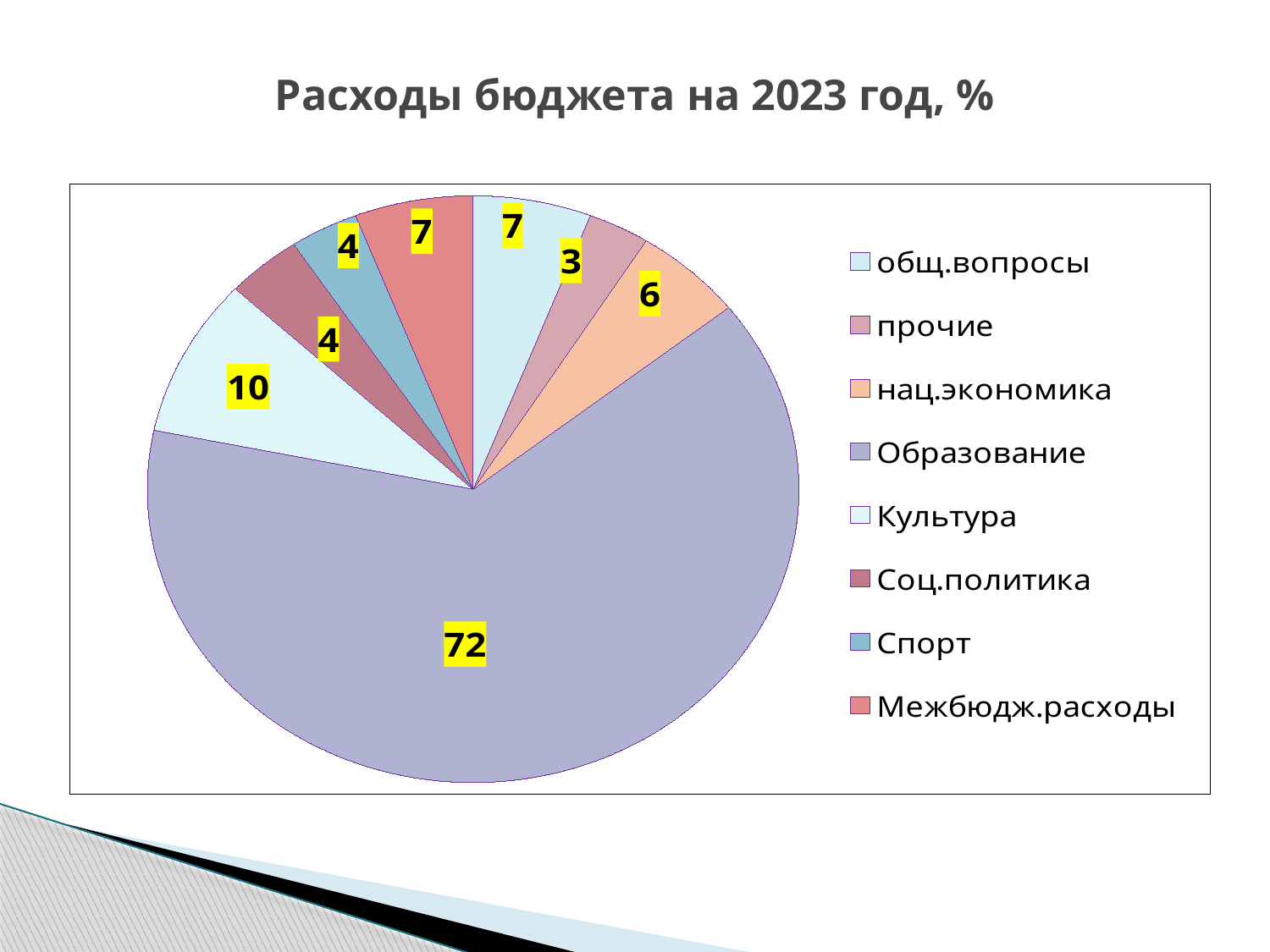
What kind of chart is shown on the slide? pie chart What is the value for Культура? 10 Which category has the smallest slice of the pie? прочие Which is larger, the value for нац.экономика or the value for прочие? нац.экономика How many categories does the pie chart show? 8 What is the difference between the values for Образование and Культура? 62 What is the title of the chart? Расходы бюджета на 2023 год, % What is the value for прочие? 3 What is the value for Образование? 72 What is the value for нац.экономика? 6 Which two categories both have a value of 4? Соц.политика and Спорт Which category has the largest slice of the pie? Образование